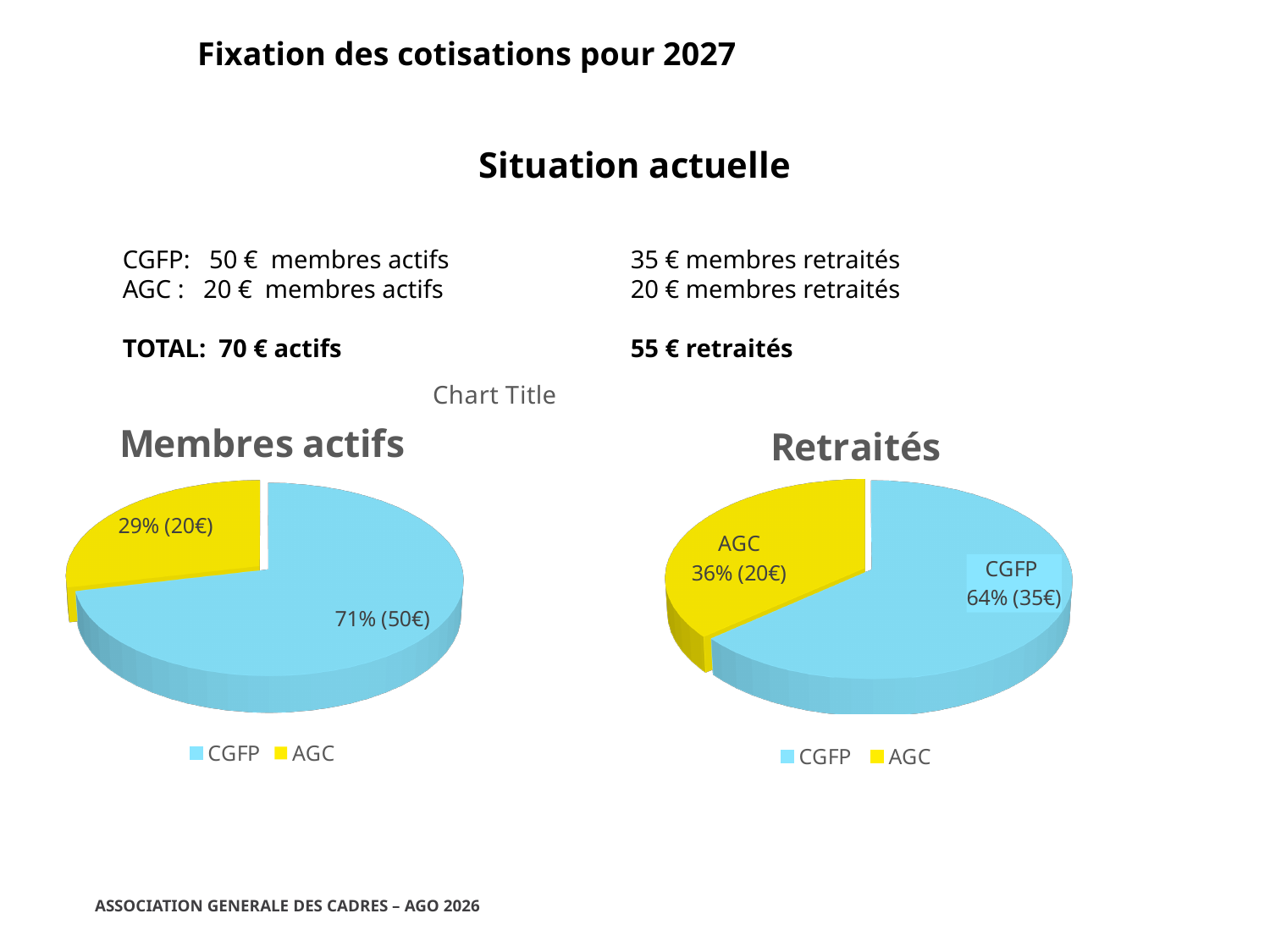
In the "Membres actifs" chart, which slice is the smallest? AGC In the "Retraités" chart, which slice is the largest? CGFP In the "Retraités" chart, what amount is shown for AGC? 20€ In the "Membres actifs" chart, what amount is shown for CGFP? 50€ In the "Membres actifs" chart, what share of the pie does AGC hold? 29% In the "Retraités" chart, what share of the pie does CGFP hold? 64% In the "Membres actifs" chart, what share of the pie does CGFP hold? 71% In the "Retraités" chart, what is the difference in euros between the CGFP and AGC amounts? 15€ Which entries does the legend of the "Membres actifs" chart list? CGFP and AGC How many slices does the "Retraités" pie chart have? 2 What kind of chart is the "Membres actifs" chart? Pie chart In the "Membres actifs" chart, what amount is shown for AGC? 20€